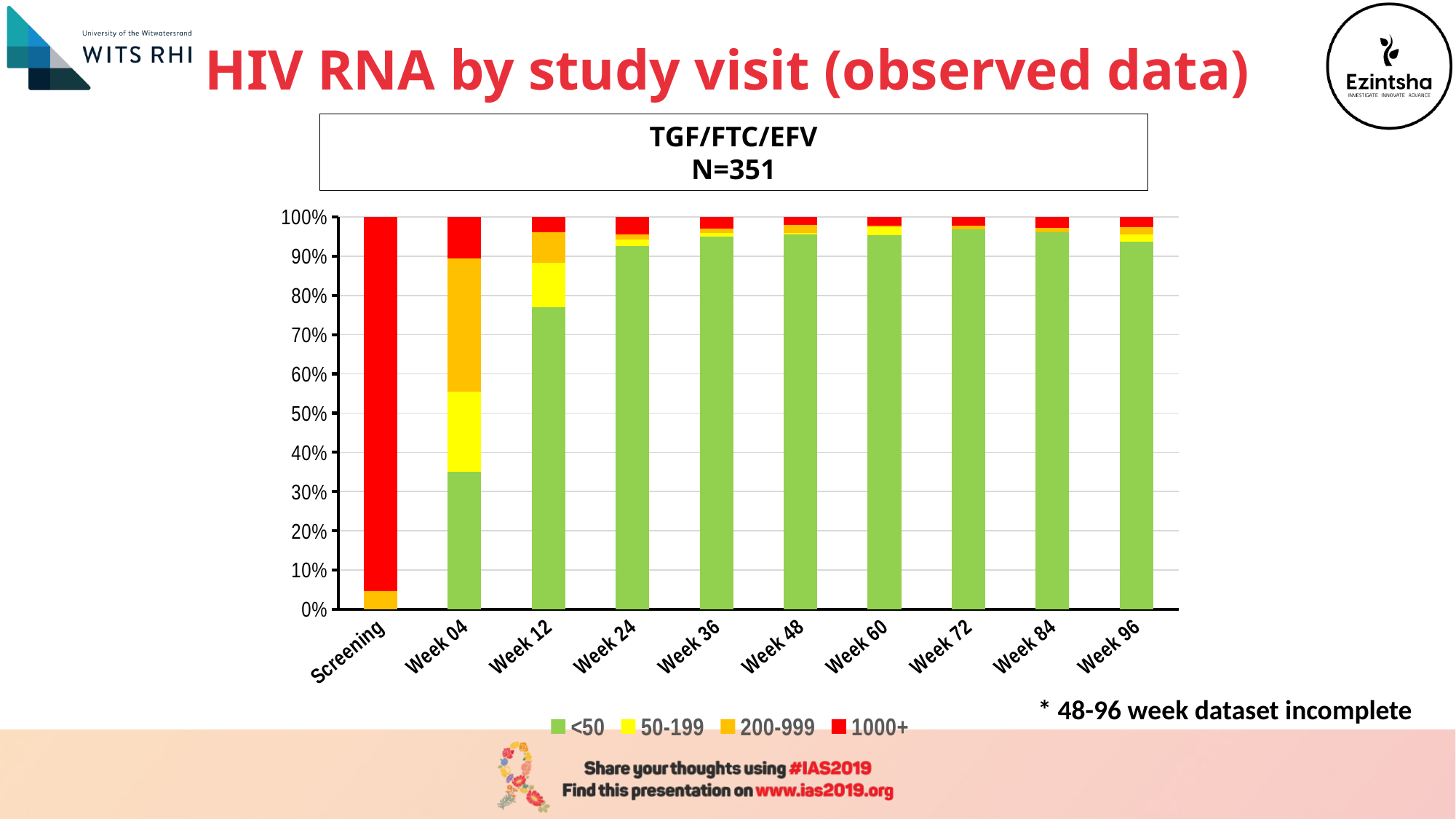
Which study visit has the largest 1000+ share? Screening Which has the larger <50 share, Week 04 or Week 12? Week 12 What are the four categories listed in the legend? <50, 50-199, 200-999, 1000+ Is the <50 share at Week 24 greater or less than 90%? greater Is the 1000+ share at Screening greater or less than 90%? greater How many series does the legend list? 4 Is the <50 share at Week 04 greater or less than 40%? less What kind of chart is shown on the slide? Stacked bar chart Which study visit has the smallest <50 share? Screening What label and sample size are shown in the box above the chart? TGF/FTC/EFV N=351 How many study visits are shown along the x axis? 10